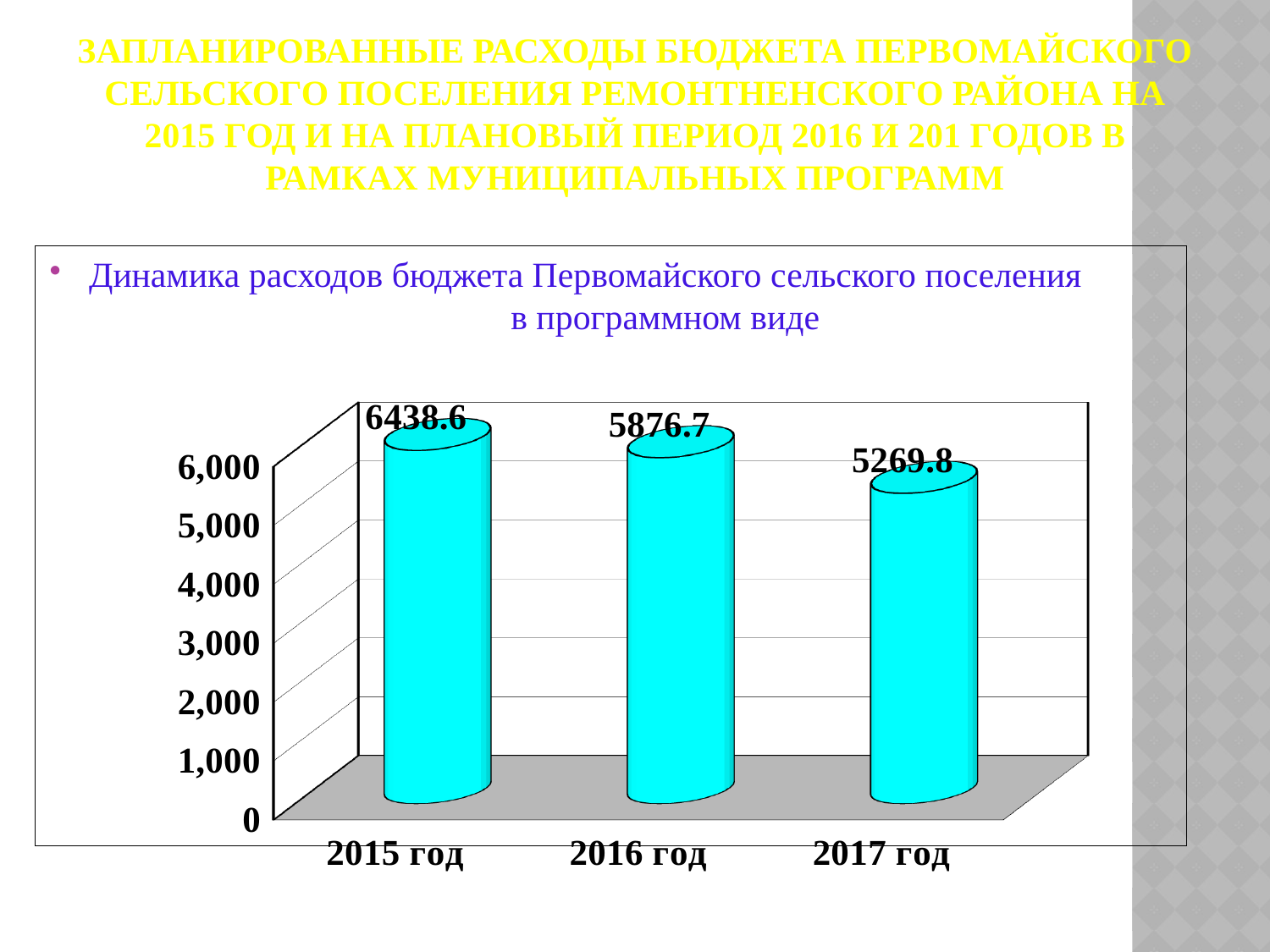
What is the value shown for 2016 год? 5876.7 What is the difference between the values for 2015 год and 2017 год? 1168.8 What is the difference between the values for 2016 год and 2017 год? 606.9 What kind of chart is shown on the slide? bar chart Which is larger, the value for 2016 год or the value for 2017 год? 2016 год How many years are shown on the x axis? 3 What is the value shown for 2015 год? 6438.6 What is the value shown for 2017 год? 5269.8 Which year has the lowest value? 2017 год Do the values rise or fall from 2015 год to 2017 год? fall Which year has the highest value? 2015 год What is the difference between the values for 2015 год and 2016 год? 561.9